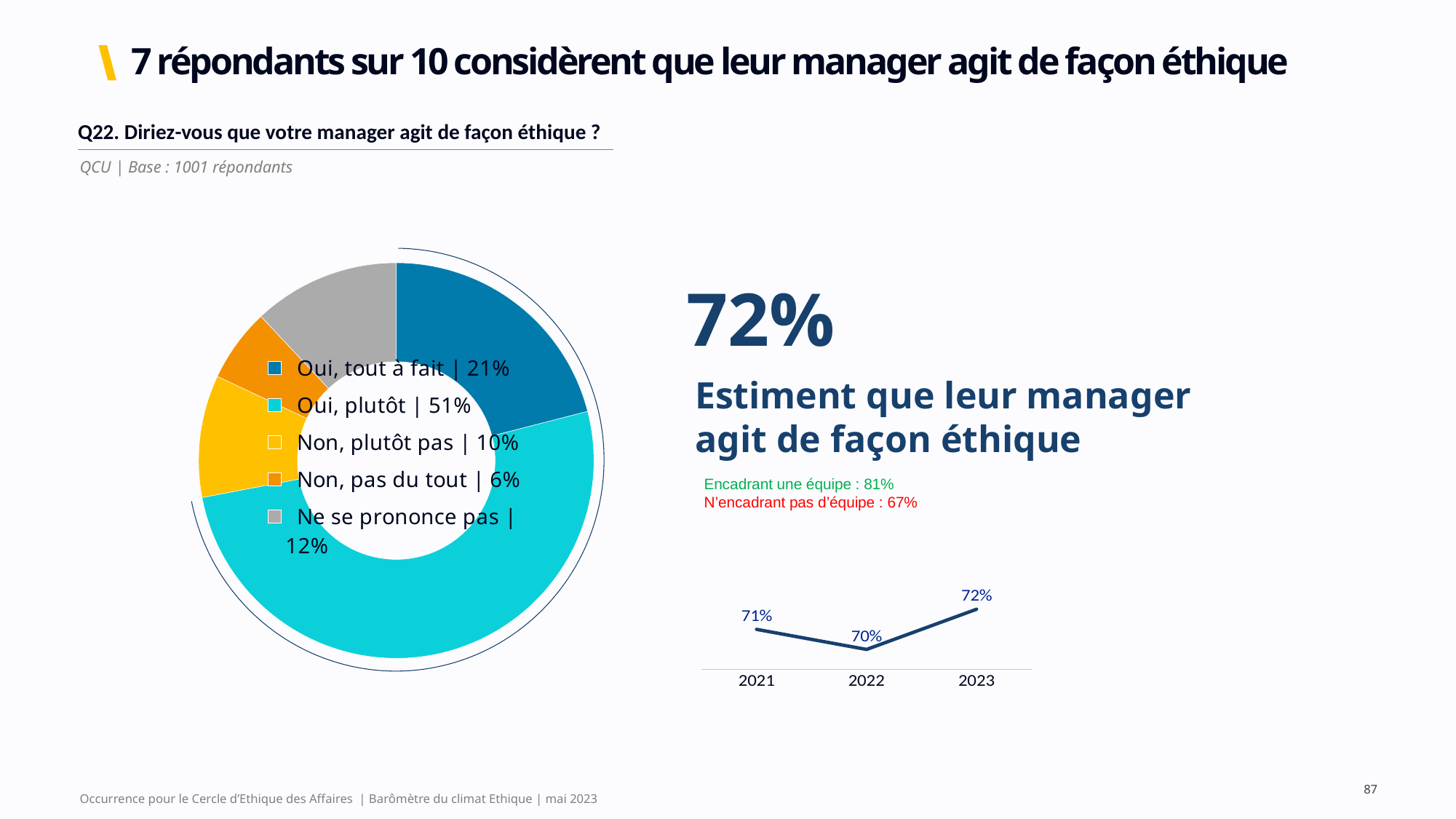
In the line chart at the bottom right, which year has the highest value? 2023 How many response categories does the legend of the donut chart on the left list? 5 In the line chart at the bottom right, how many years are plotted? 3 In the donut chart on the left, which is larger: "Non, plutôt pas" or "Ne se prononce pas"? Ne se prononce pas In the donut chart on the left, what is the difference in percentage points between "Oui, plutôt" and "Oui, tout à fait"? 30 In the donut chart on the left, what share of respondents answered "Oui, plutôt"? 51% In the line chart at the bottom right, what is the value for 2022? 70% What type of chart is shown on the left of the slide? Donut chart In the donut chart on the left, which response category has the largest share? Oui, plutôt In the donut chart on the left, what share of respondents answered "Non, pas du tout"? 6% In the donut chart on the left, what share of respondents answered "Ne se prononce pas"? 12% In the donut chart on the left, which response category has the smallest share? Non, pas du tout